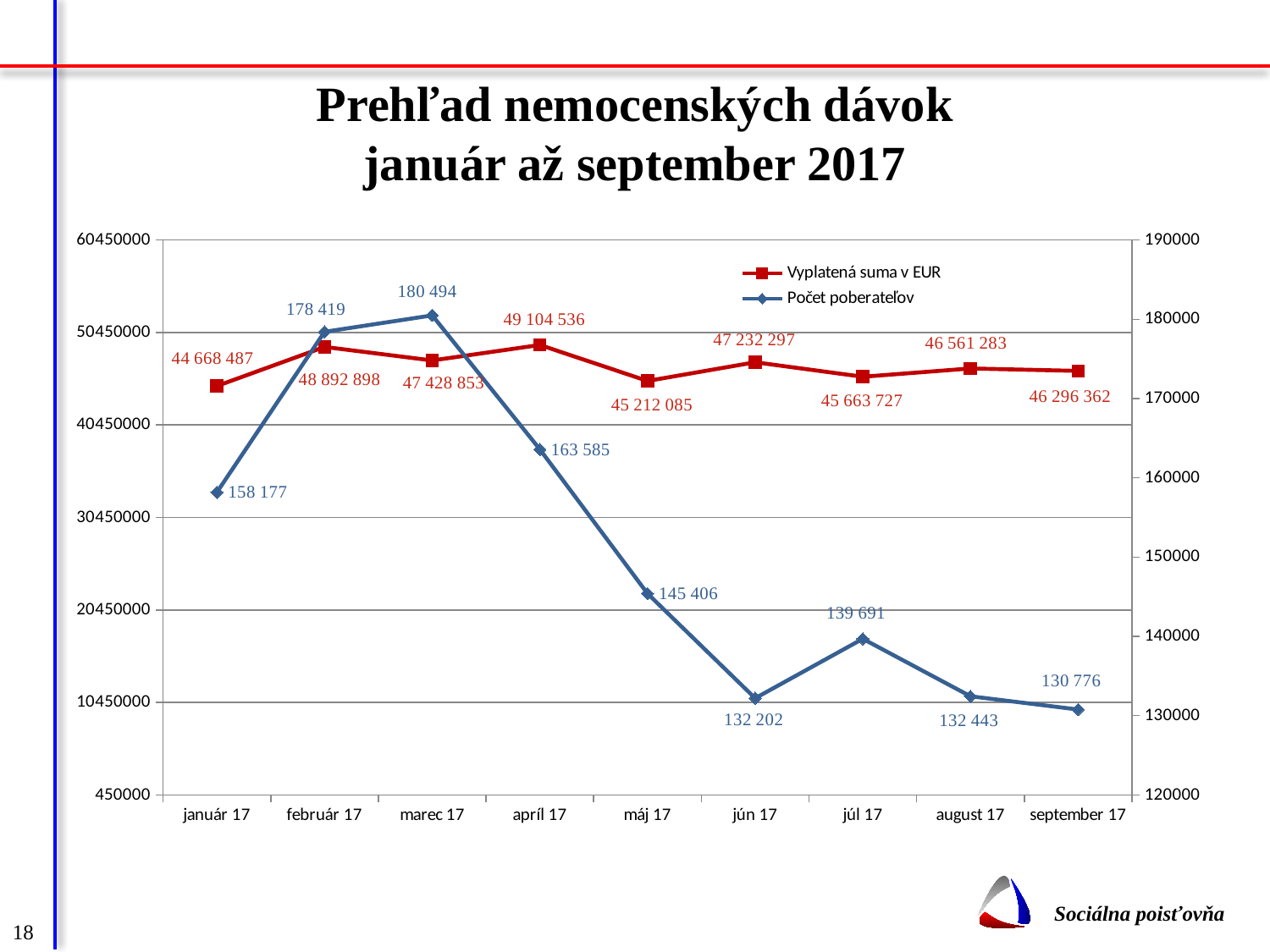
Which is larger, Vyplatená suma v EUR for február 17 or for marec 17? február 17 What kind of chart is shown on the slide? line chart What is the value of Počet poberateľov for jún 17? 132 202 In which month is Počet poberateľov the highest? marec 17 How many months are shown on the x axis? 9 In which month is Vyplatená suma v EUR the lowest? január 17 What is the difference between the highest and lowest values of Počet poberateľov? 49 718 In which month is Počet poberateľov the lowest? september 17 What is the value of Počet poberateľov for marec 17? 180 494 In which month is Vyplatená suma v EUR the highest? apríl 17 How many series does the legend list? 2 What is the value of Vyplatená suma v EUR for apríl 17? 49 104 536